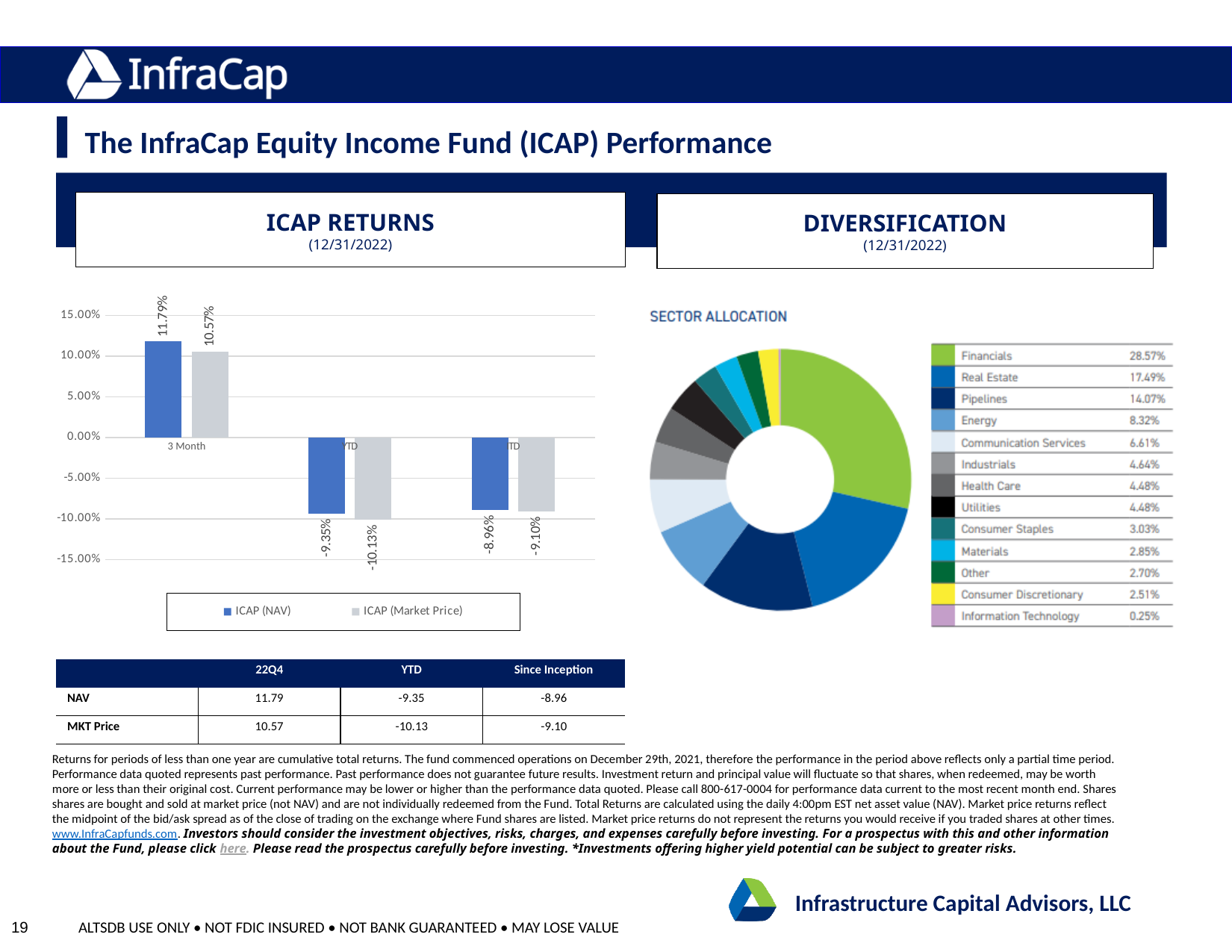
In the Sector Allocation chart, which sector has the smallest share? Information Technology How many series does the legend of the ICAP Returns chart list? 2 In the ICAP Returns chart, which is larger for YTD: ICAP (NAV) or ICAP (Market Price)? ICAP (NAV) In the Sector Allocation chart, what is the share for Pipelines? 14.07% What kind of chart is the ICAP Returns chart? Bar chart In the ICAP Returns chart, what is the ICAP (NAV) value for 3 Month? 11.79% In the Sector Allocation chart, which sector has the largest share? Financials In the ICAP Returns chart, is the ICAP (NAV) value for 3 Month greater or less than 10.00%? greater In the ICAP Returns chart, what is the difference between the ICAP (NAV) and ICAP (Market Price) values for 3 Month? 1.22% How many sectors are listed in the Sector Allocation chart? 13 In the ICAP Returns chart, what is the ICAP (Market Price) value for YTD? -10.13% What kind of chart is the Sector Allocation chart? Donut (pie) chart